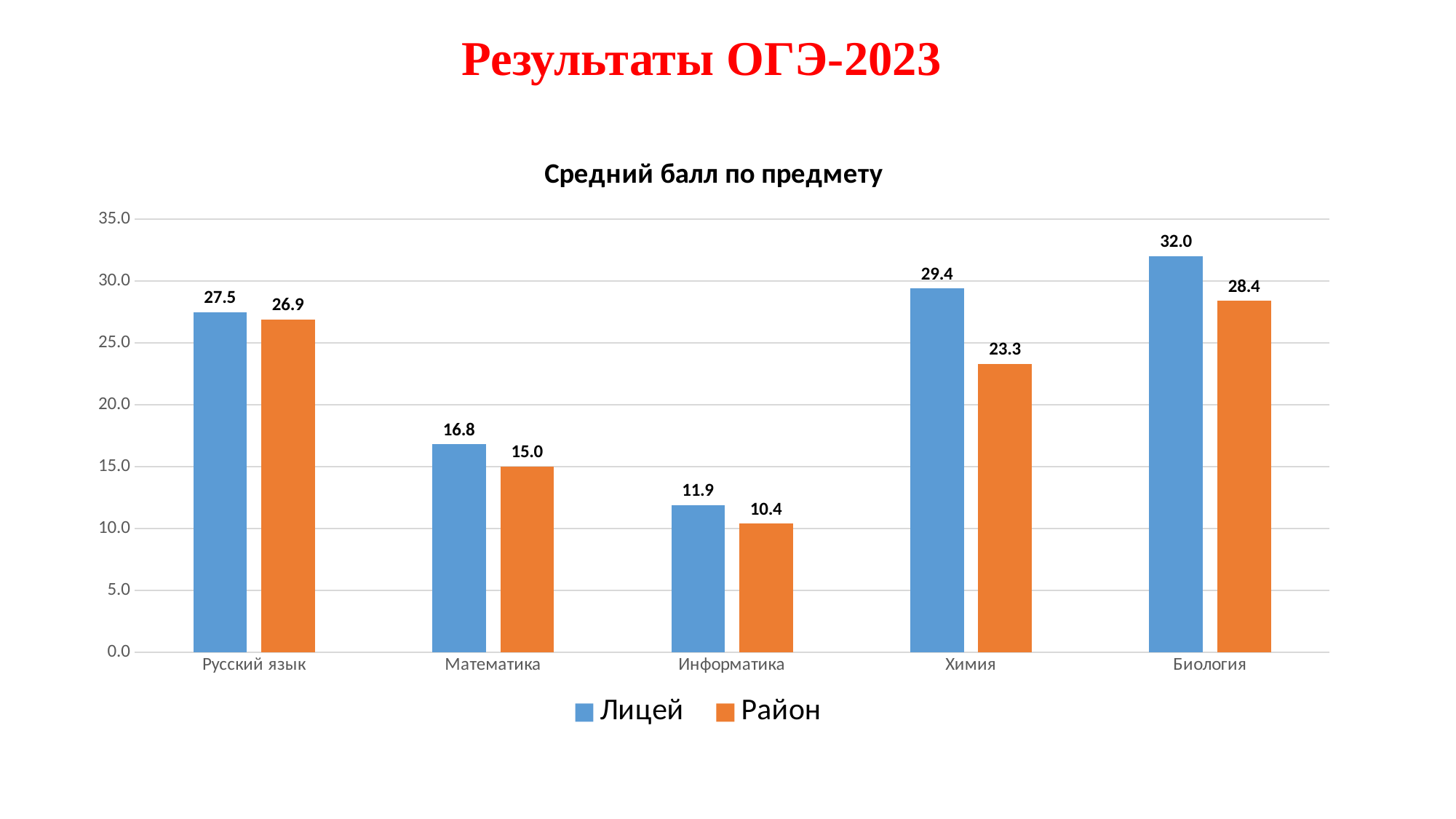
Which subject has the highest value for Лицей? Биология What is the value for Лицей in Химия? 29.4 Which is larger in Информатика: Лицей or Район? Лицей What is the value for Район in Математика? 15.0 How many series does the legend list? 2 Which subject has the lowest value for Район? Информатика What is the difference between Лицей and Район in Русский язык? 0.6 Is the value for Район in Химия greater or less than 25.0? less What is the difference between Лицей and Район in Химия? 6.1 What is the value for Район in Биология? 28.4 How many subjects are shown on the x axis? 5 What kind of chart is shown on the slide? bar chart